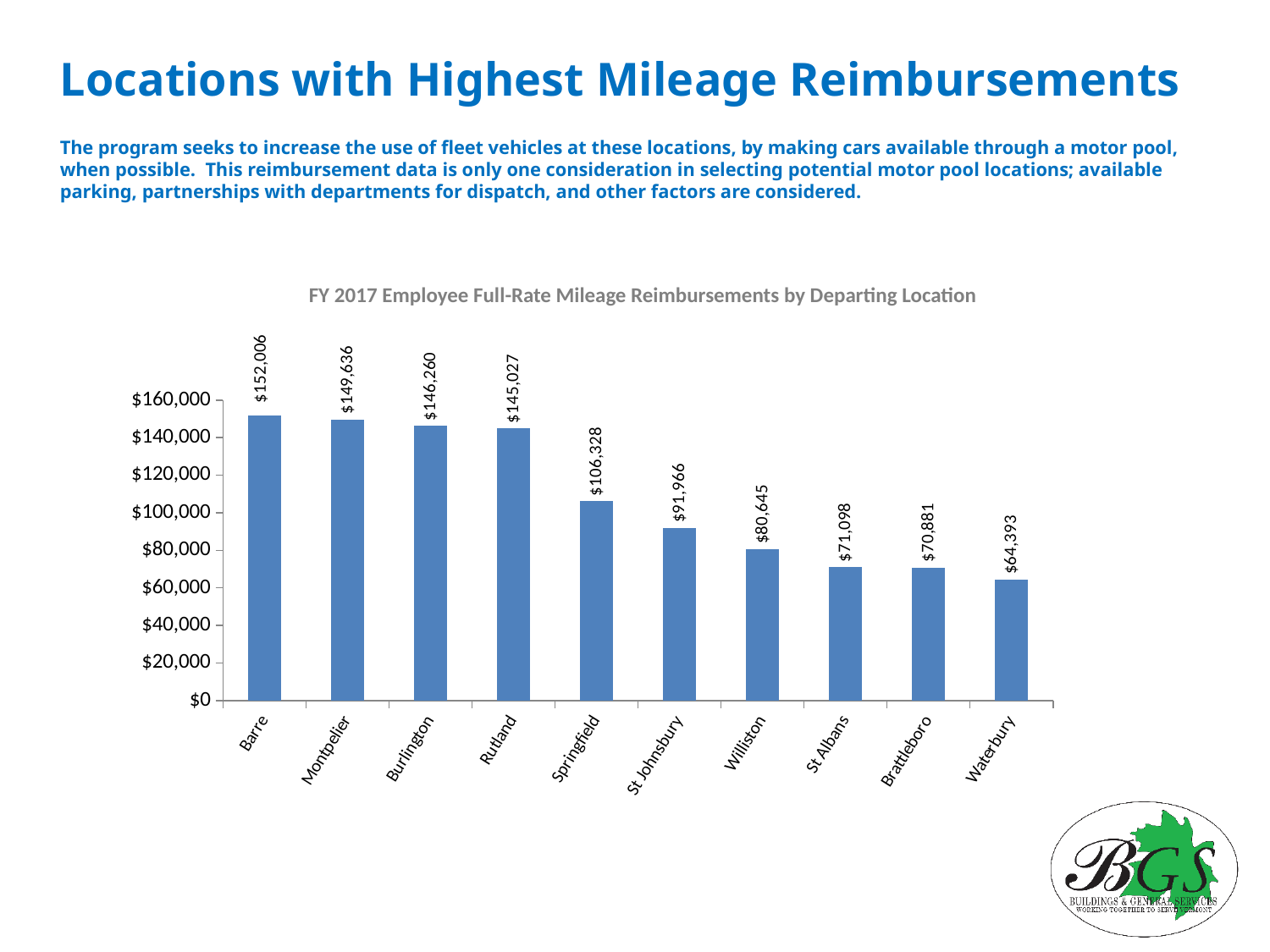
What is the value for Waterbury? $64,393 What is the value for Barre? $152,006 Which location has the lowest mileage reimbursement? Waterbury How many locations are shown in the chart? 10 What is the difference between the values for Springfield and St Johnsbury? $14,362 What is the title of the chart? FY 2017 Employee Full-Rate Mileage Reimbursements by Departing Location What is the value for Springfield? $106,328 Which is larger, the value for Williston or the value for St Albans? Williston Which location has the highest mileage reimbursement? Barre What kind of chart is shown on the slide? bar chart What is the difference between the values for Barre and Waterbury? $87,613 Is the value for Springfield greater or less than $100,000? greater